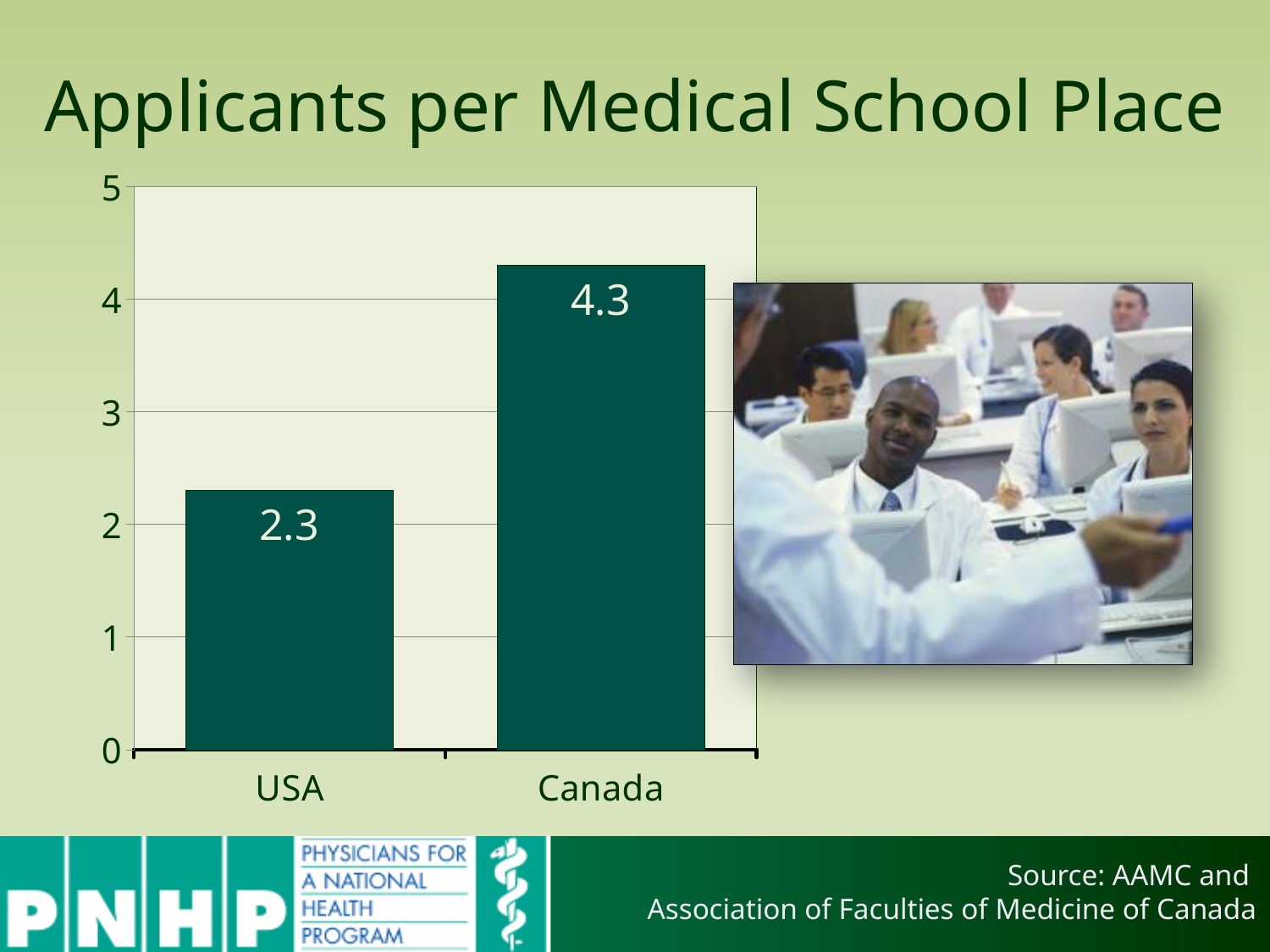
Is the value for the USA greater or less than 3? less How many countries are shown in the chart? 2 What kind of chart is shown on the slide? bar chart Is the value for Canada greater or less than 4? greater Which country has the lower number of applicants per medical school place? USA Is the value for Canada larger or smaller than the value for the USA? larger What is the difference between Canada's and the USA's applicants per medical school place? 2.0 Which country has the higher number of applicants per medical school place? Canada What is the number of applicants per medical school place for Canada? 4.3 What is the maximum value shown on the vertical axis? 5 What is the number of applicants per medical school place for the USA? 2.3 What is the title of the chart? Applicants per Medical School Place